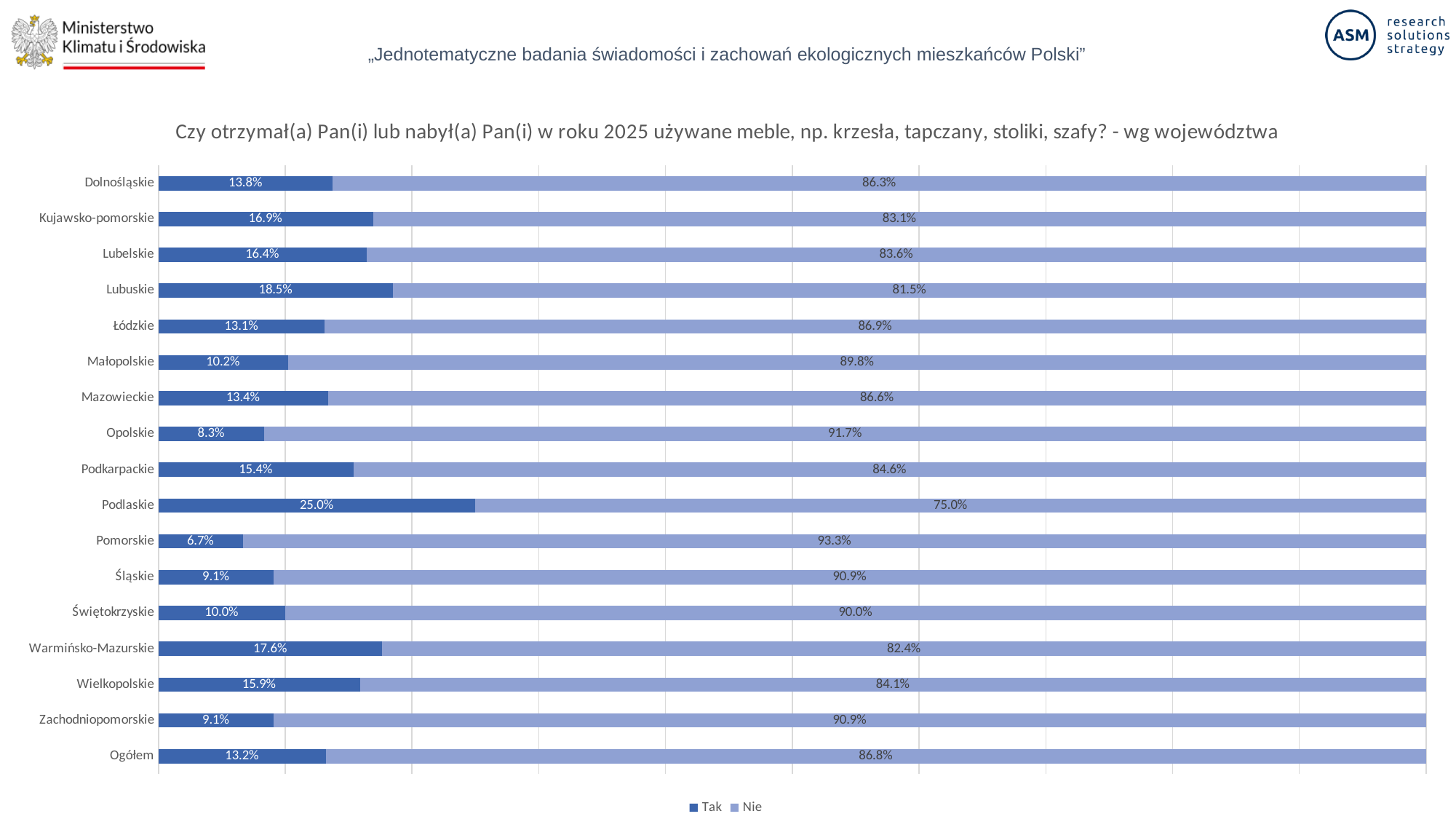
What is the "Nie" value for Pomorskie? 93.3% What is the total of the stacked bar for Opolskie? 100.0% What are the two series named in the legend? Tak and Nie What is the "Tak" value for Ogółem? 13.2% What is the "Tak" value for Podlaskie? 25.0% What kind of chart is shown on the slide? Stacked bar chart Which has a larger "Tak" value, Kujawsko-pomorskie or Lubelskie? Kujawsko-pomorskie How many series does the legend list? 2 Which voivodeship has the highest "Tak" value? Podlaskie How many categories (rows) are shown on the chart? 17 Which voivodeship has the lowest "Tak" value? Pomorskie What is the difference between the "Tak" values for Lubuskie and Małopolskie? 8.3 percentage points